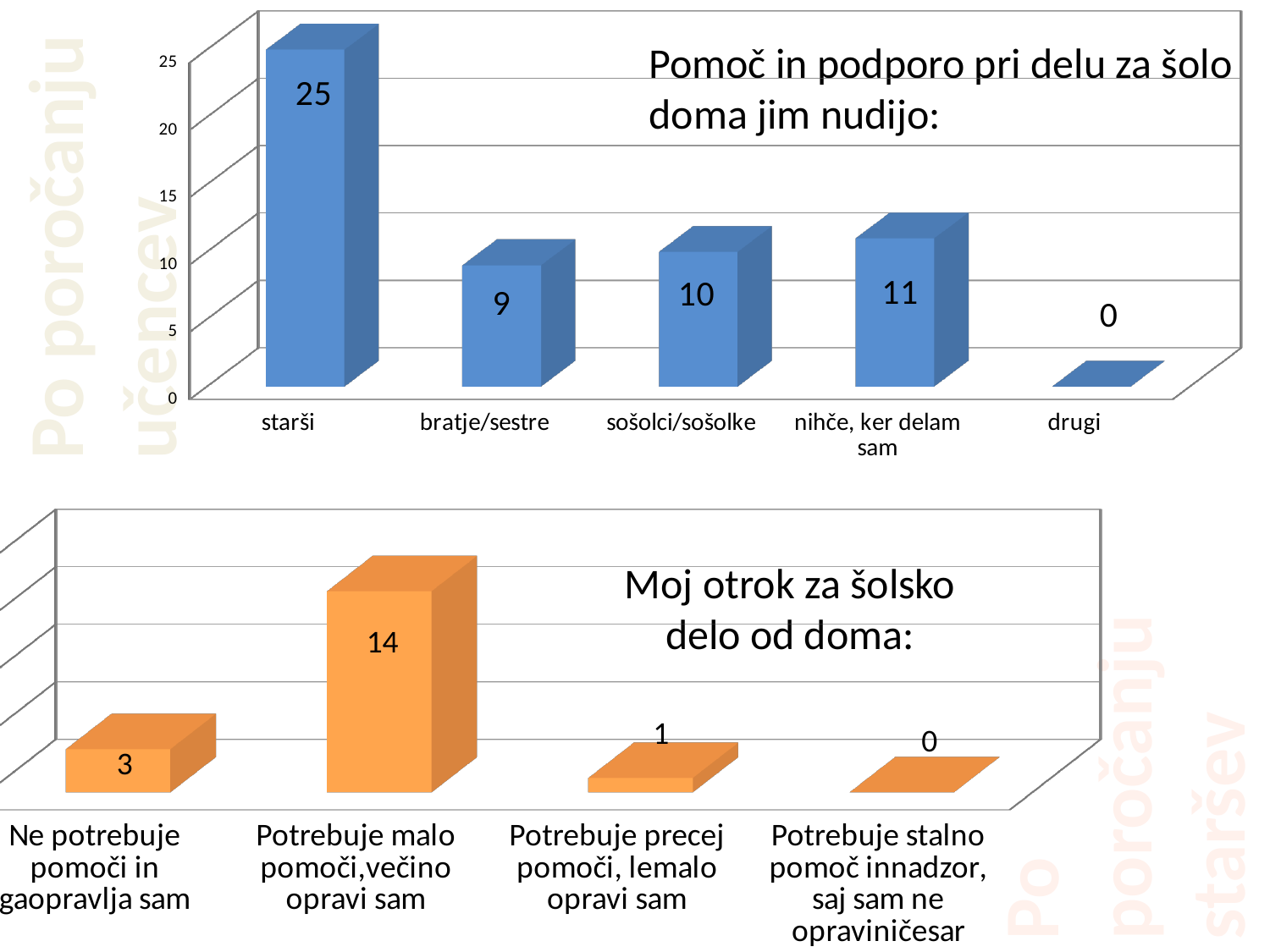
In the top chart 'Pomoč in podporo pri delu za šolo doma jim nudijo:', how many categories are shown? 5 In the bottom chart 'Moj otrok za šolsko delo od doma:', which category has the highest value? Potrebuje malo pomoči, večino opravi sam In the top chart 'Pomoč in podporo pri delu za šolo doma jim nudijo:', what is the difference between the values for 'starši' and 'nihče, ker delam sam'? 14 In the top chart 'Pomoč in podporo pri delu za šolo doma jim nudijo:', which category has the highest value? starši In the bottom chart 'Moj otrok za šolsko delo od doma:', what is the difference between the values for 'Potrebuje malo pomoči, večino opravi sam' and 'Ne potrebuje pomoči'? 11 In the top chart 'Pomoč in podporo pri delu za šolo doma jim nudijo:', what is the value for 'bratje/sestre'? 9 In the bottom chart 'Moj otrok za šolsko delo od doma:', what is the value for 'Potrebuje precej pomoči, le malo opravi sam'? 1 In the bottom chart 'Moj otrok za šolsko delo od doma:', what is the value for 'Potrebuje malo pomoči, večino opravi sam'? 14 In the top chart 'Pomoč in podporo pri delu za šolo doma jim nudijo:', which category has the lowest value? drugi What type of chart is the bottom chart 'Moj otrok za šolsko delo od doma:'? bar chart In the top chart 'Pomoč in podporo pri delu za šolo doma jim nudijo:', which is larger: 'sošolci/sošolke' or 'bratje/sestre'? sošolci/sošolke In the top chart 'Pomoč in podporo pri delu za šolo doma jim nudijo:', what is the value for 'starši'? 25